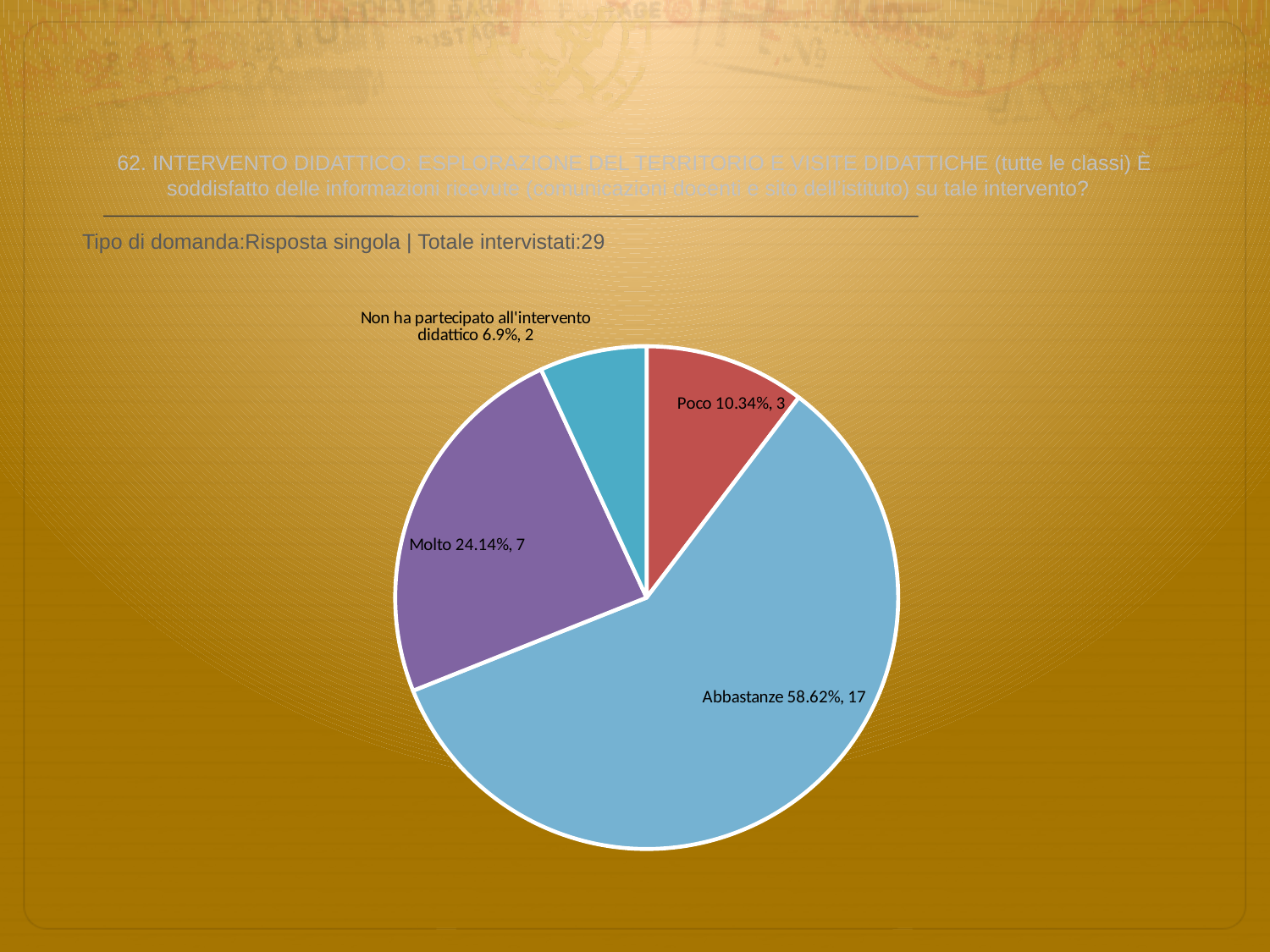
What percentage share does the 'Poco' slice have? 10.34% How many slices does the pie chart have? 4 Which category has the largest slice of the pie? Abbastanze How many respondents answered 'Molto'? 7 How many respondents are in the 'Non ha partecipato all'intervento didattico' slice? 2 Which slice is larger, 'Poco' or 'Molto'? Molto What kind of chart is shown on the slide? pie chart What is the total number of respondents across all slices? 29 What percentage share does the 'Abbastanze' slice have? 58.62% What is the difference in respondent count between 'Abbastanze' and 'Molto'? 10 What colour is the 'Molto' slice? purple Which category has the smallest slice of the pie? Non ha partecipato all'intervento didattico